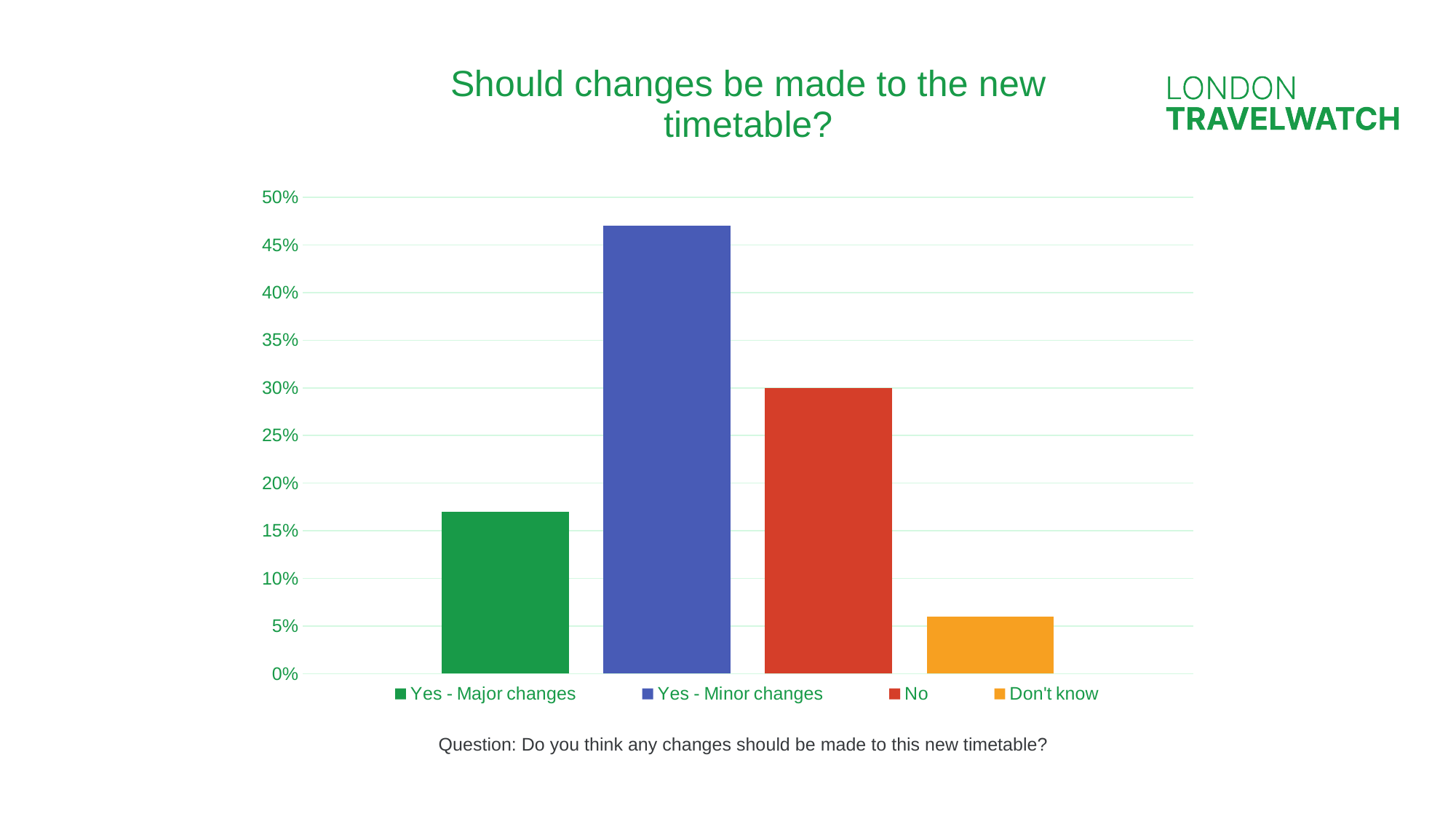
Is the value for "Yes - Minor changes" greater or less than 45%? greater What colour is the bar for "Don't know"? orange How many response categories are plotted in the chart? 4 Which response category has the highest value? Yes - Minor changes What is the value for "No"? 30% Is the value for "Don't know" greater or less than 10%? less What kind of chart is shown on the slide? bar chart How many entries does the legend list? 4 Which is larger, the value for "No" or the value for "Yes - Major changes"? No Is the value for "Yes - Major changes" greater or less than 20%? less What is the title of the chart? Should changes be made to the new timetable? Which response category has the lowest value? Don't know